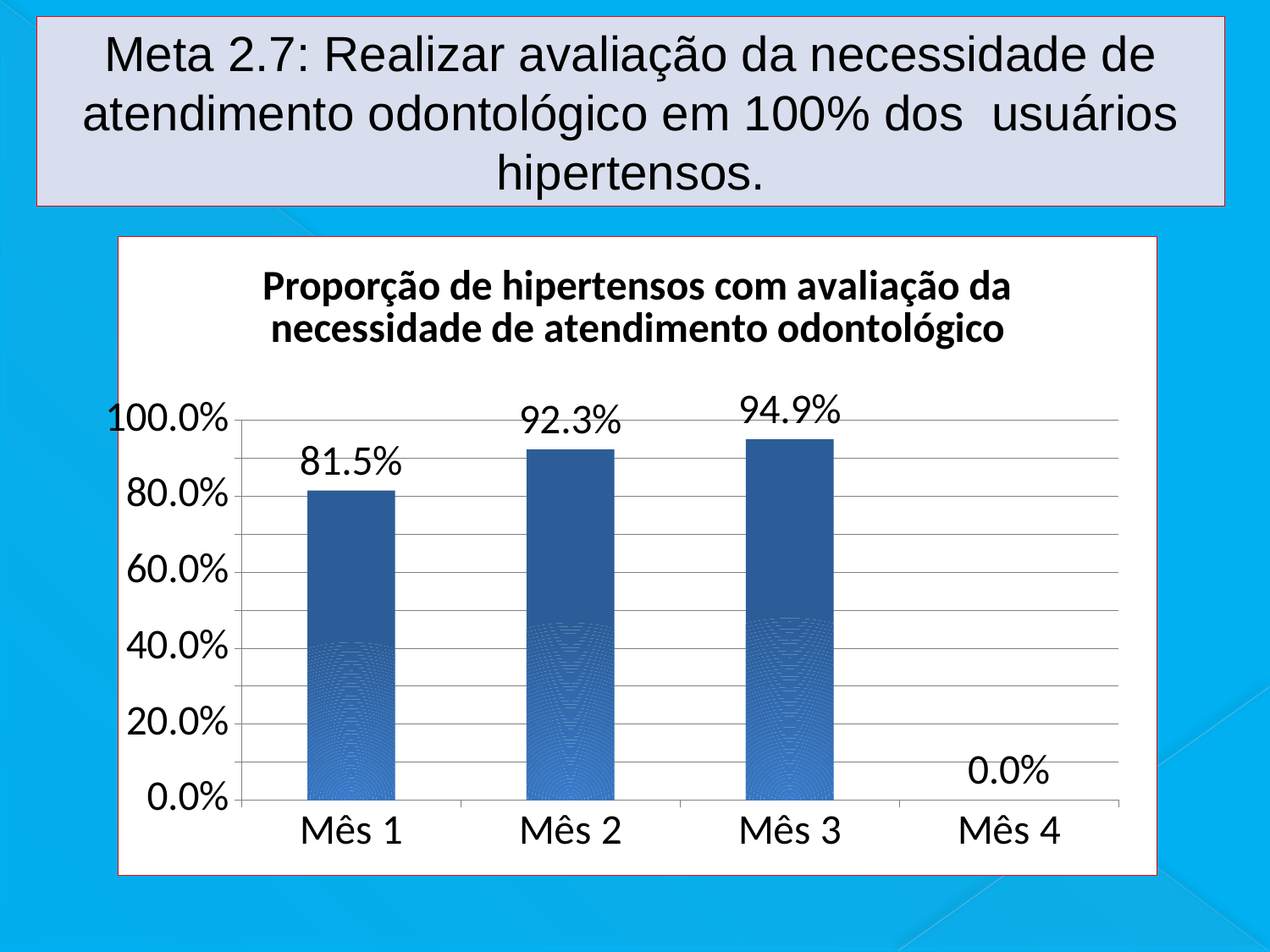
Which month has the highest value? Mês 3 Which is larger, the value for Mês 1 or the value for Mês 2? Mês 2 Which month has the lowest value? Mês 4 What is the value for Mês 4? 0.0% Is the value for Mês 1 greater or less than 80.0%? greater What is the value for Mês 3? 94.9% What is the difference between the values for Mês 3 and Mês 1? 13.4% What is the value for Mês 1? 81.5% What is the title of the chart? Proporção de hipertensos com avaliação da necessidade de atendimento odontológico What kind of chart is shown? bar chart How many months are shown on the x axis? 4 What is the value for Mês 2? 92.3%